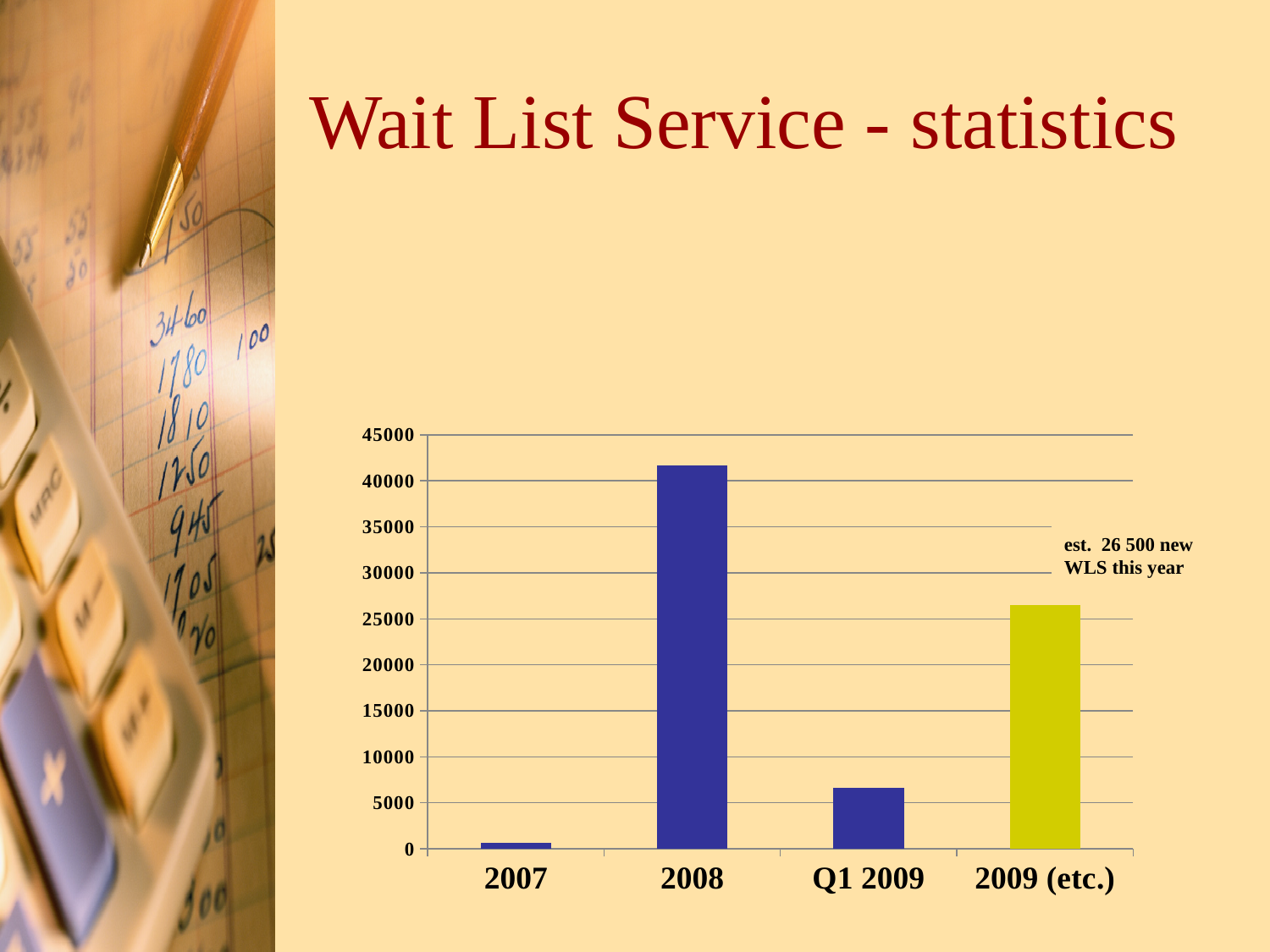
How many categories are shown on the x axis of the chart? 4 Which category has the lowest bar in the chart? 2007 Which is larger, the value for Q1 2009 or the value for 2009 (etc.)? 2009 (etc.) Which is larger, the value for 2007 or the value for Q1 2009? Q1 2009 What kind of chart is shown on the slide? bar chart Is the value for 2008 greater or less than 40000? greater Is the value for 2009 (etc.) greater or less than 25000? greater What is the title of the slide containing the chart? Wait List Service - statistics Is the value for Q1 2009 greater or less than 10000? less What estimated number of new WLS this year does the annotation on the chart give? 26 500 Which category has the highest bar in the chart? 2008